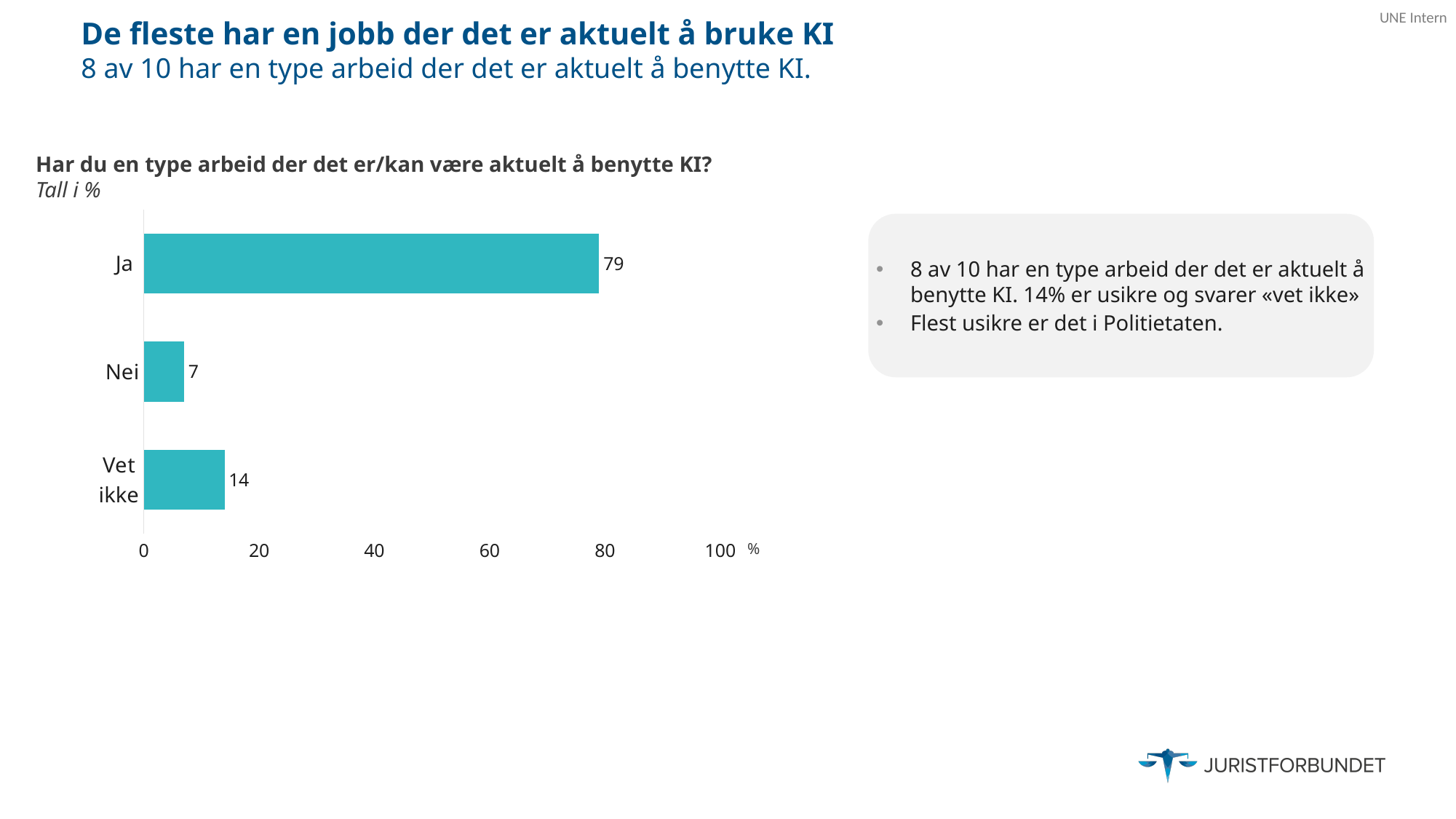
Which category has the highest value? Ja What kind of chart is shown on the slide? Bar chart Is the value for "Ja" greater or less than 60? greater How many categories are shown in the chart? 3 What is the value for "Ja"? 79 Which is larger, the value for "Nei" or the value for "Vet ikke"? Vet ikke What is the difference between the values for "Ja" and "Vet ikke"? 65 Which category has the lowest value? Nei What is the value for "Vet ikke"? 14 What is the difference between the values for "Vet ikke" and "Nei"? 7 What question is the chart titled with? Har du en type arbeid der det er/kan være aktuelt å benytte KI? What is the value for "Nei"? 7